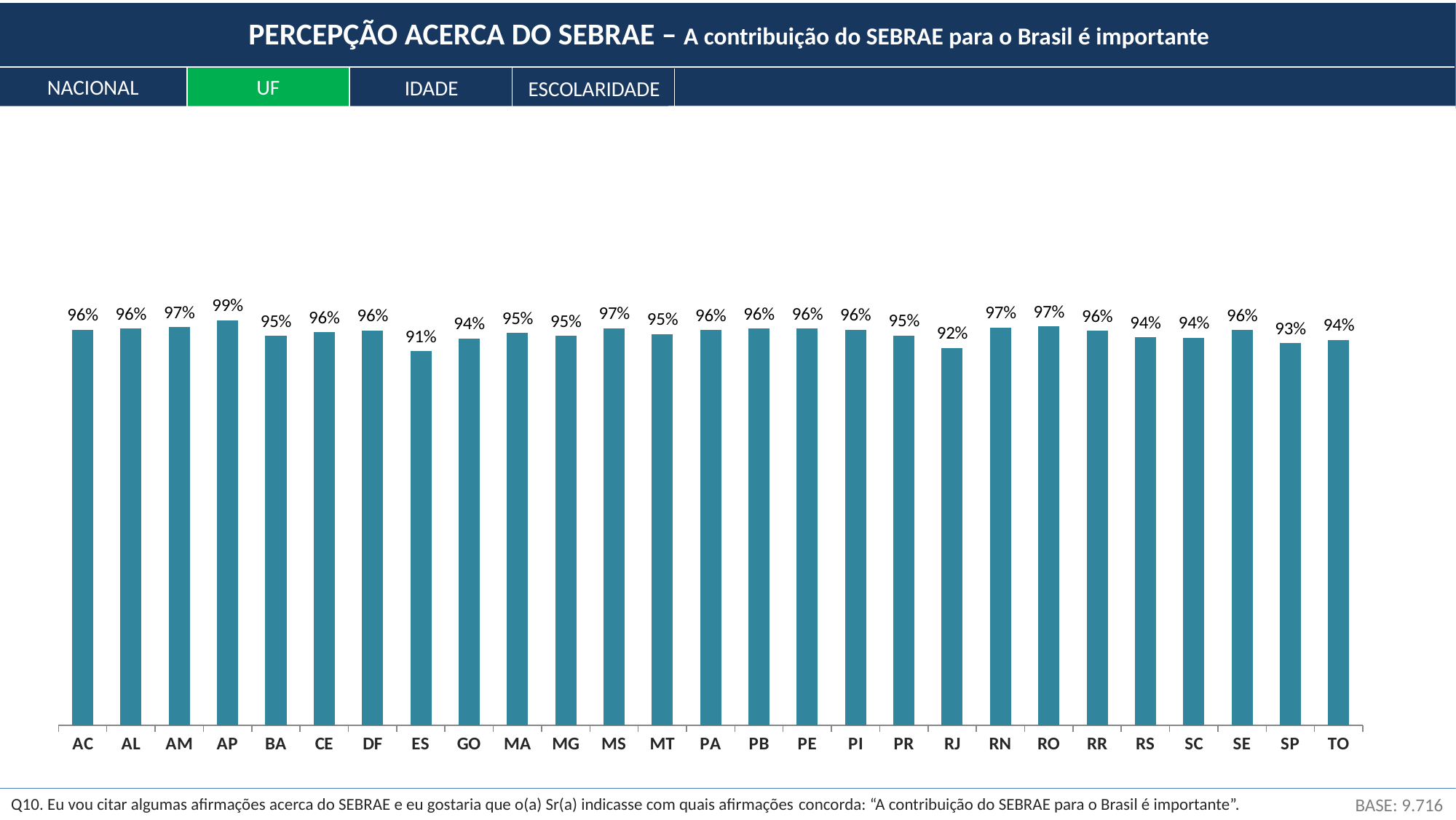
What is the value for SP? 93% What is the difference between the values for RN and RJ? 5 percentage points Which state has the highest value? AP What is the value for AP? 99% Which state has the lowest value? ES How many states (UFs) are shown on the x axis? 27 What is the difference between the values for AP and ES? 8 percentage points What is the value for RJ? 92% Which tab is highlighted in green at the top of the slide? UF Which is larger, the value for MS or the value for GO? MS What kind of chart is shown on the slide? Bar chart What is the value for ES? 91%